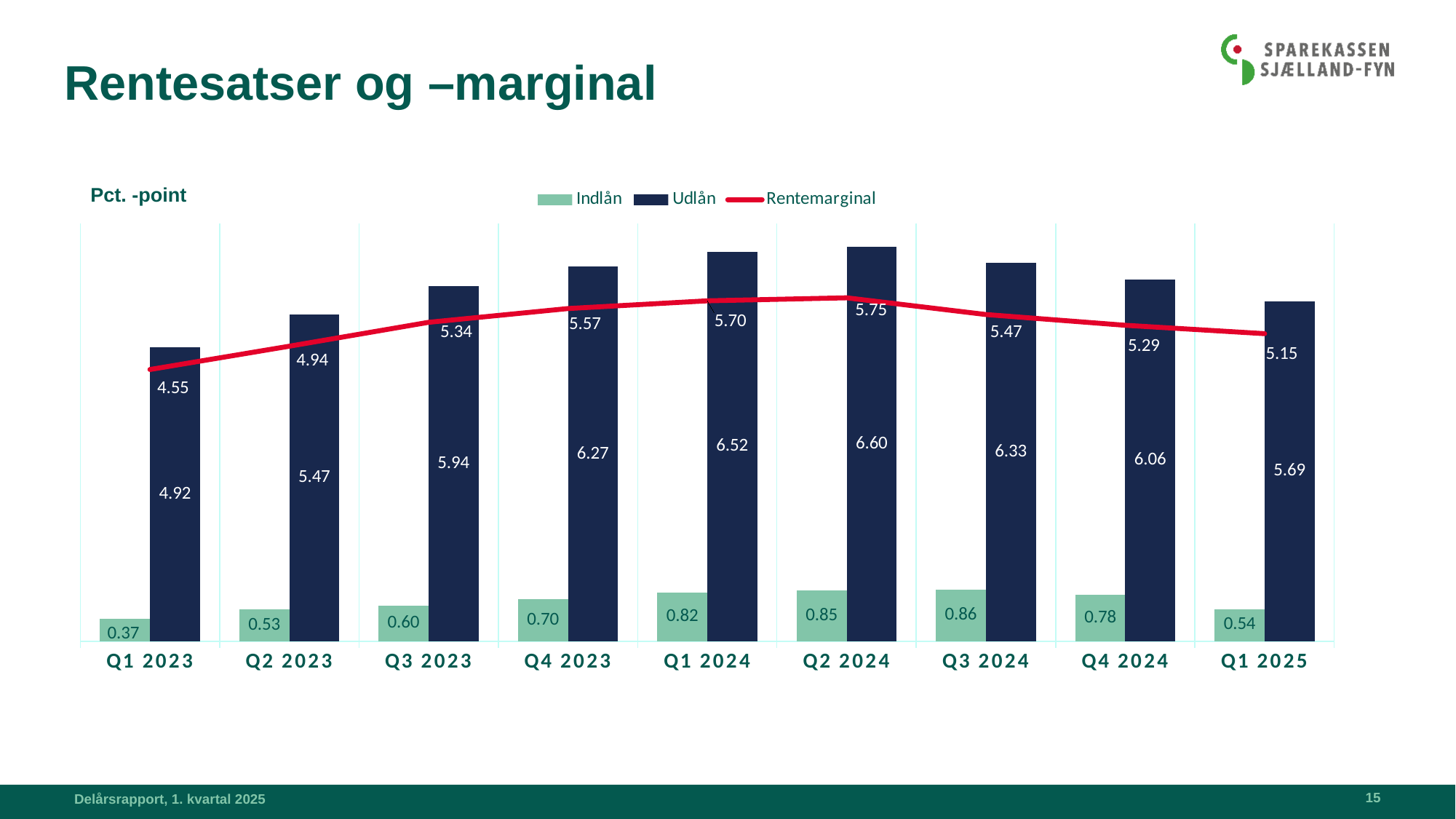
How many quarters are shown on the x axis? 9 In which quarter is the Indlån value highest? Q3 2024 What is the difference between the Udlån values for Q2 2024 and Q1 2025? 0.91 In which quarter does the Rentemarginal line reach its highest value? Q2 2024 Which is larger, the Indlån value for Q4 2024 or for Q1 2025? Q4 2024 What is the Indlån value for Q1 2023? 0.37 What is the difference between the Rentemarginal values for Q1 2023 and Q2 2024? 1.20 In which quarter is the Udlån value lowest? Q1 2023 What is the Rentemarginal value for Q1 2025? 5.15 Does the Rentemarginal line rise or fall from Q2 2024 to Q1 2025? fall What is the Udlån value for Q2 2024? 6.60 How many series does the legend list? 3